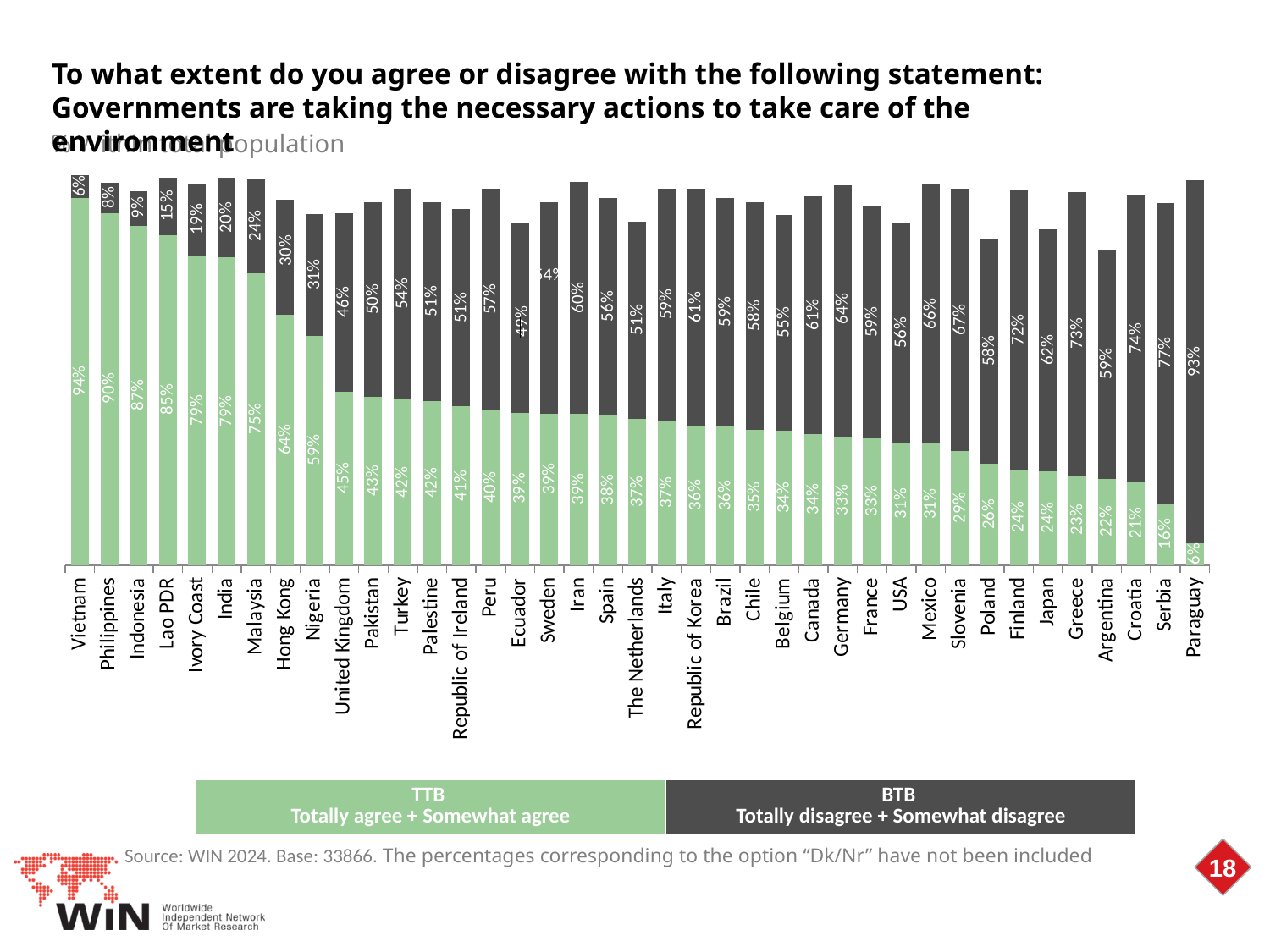
How many series does the legend list? 2 What is the difference between the TTB value for Vietnam and the TTB value for Philippines? 4% What is the BTB (totally disagree + somewhat disagree) value for Paraguay? 93% What is the total of the TTB and BTB segments for Serbia? 93% What percentage of respondents in Vietnam totally or somewhat agree (TTB) that governments are taking the necessary actions to take care of the environment? 94% What is the TTB value for Germany? 33% Which has a higher BTB (disagree) value, Mexico or USA? Mexico How many countries are shown on the chart? 39 Do the TTB (agree) values rise or fall moving from left to right across the countries? Fall Which country has the lowest TTB (agree) percentage? Paraguay What kind of chart is shown on the slide? Stacked bar chart Which country has the highest BTB (disagree) percentage? Paraguay